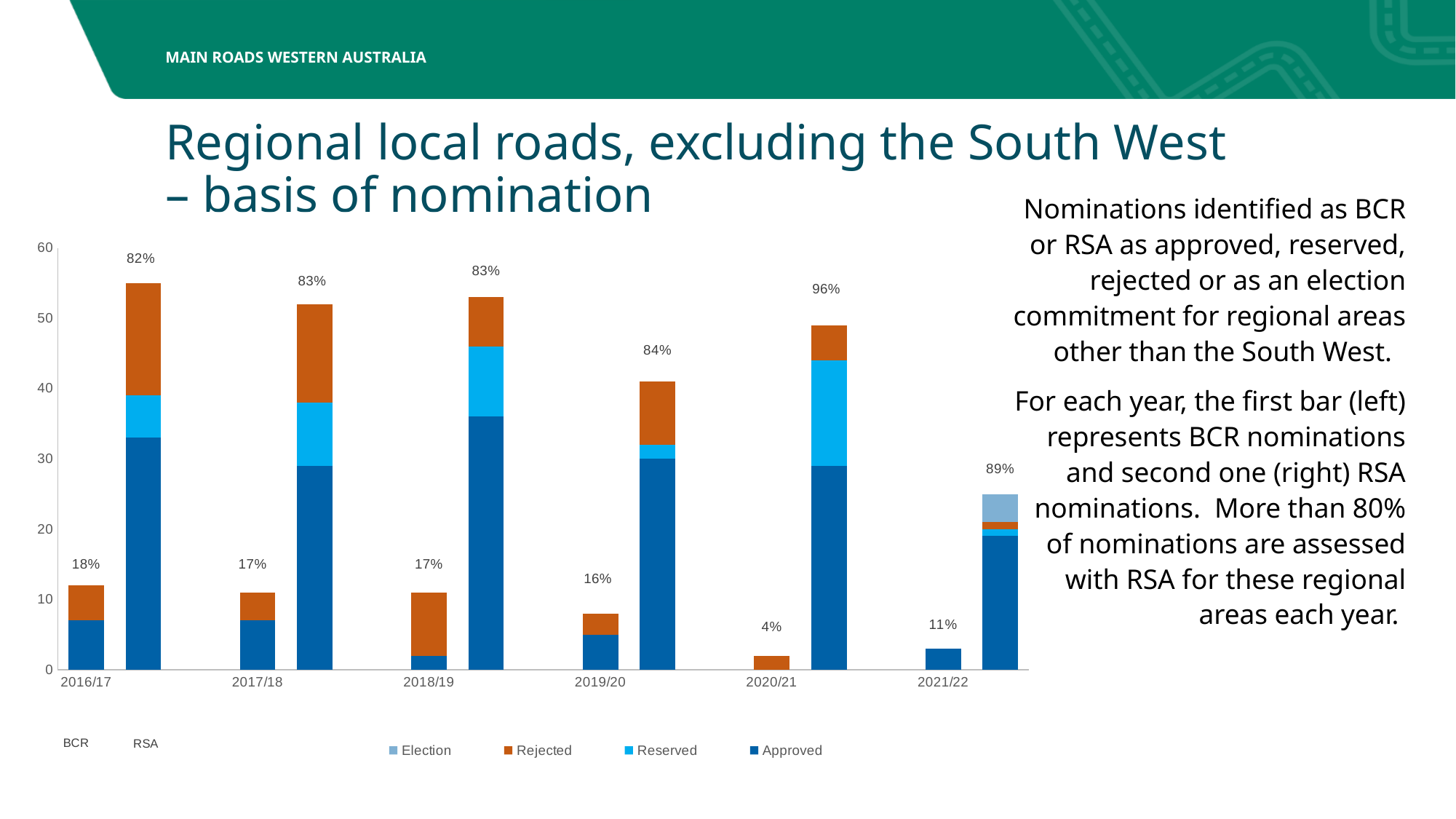
What percentage label is shown above the RSA bar for 2020/21? 96% Which year has the highest RSA percentage label? 2020/21 What percentage label is shown above the RSA bar for 2021/22? 89% Which legend entry is shown in orange? Rejected What percentage label is shown above the BCR bar for 2016/17? 18% How many series does the legend list? 4 How many years are shown on the x axis? 6 Is the total height of the BCR bar for 2021/22 greater or less than 10? less What kind of chart is shown on the slide? stacked bar chart What is the difference between the RSA and BCR percentage labels for 2019/20? 68% Is the total height of the RSA bar for 2016/17 greater or less than 50? greater Which year has the lowest BCR percentage label? 2020/21